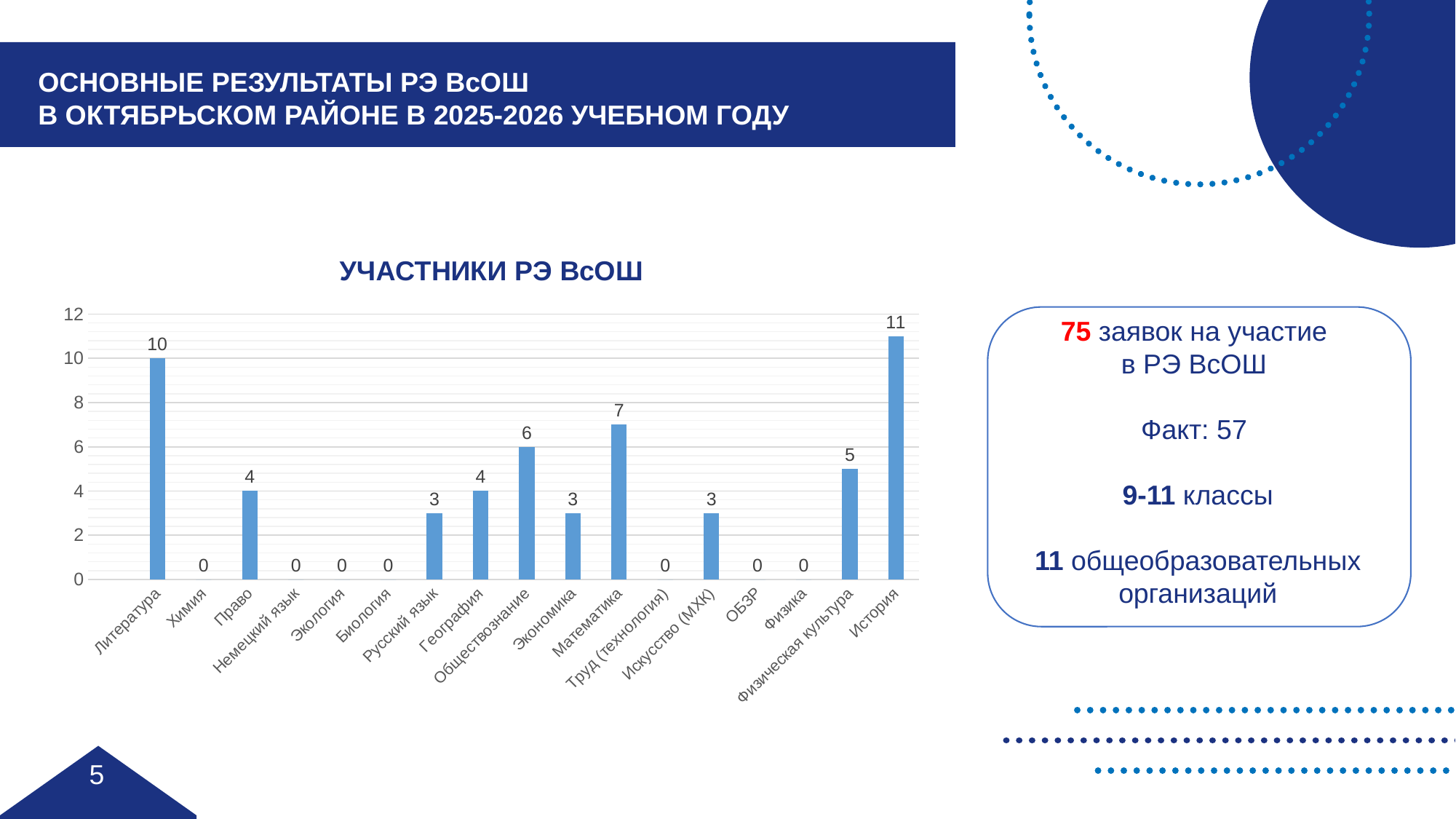
What is the value for Физическая культура in the chart? 5 What is the difference between the values for История and Литература? 1 What is the difference between the values for Математика and Экономика? 4 What is the title of the chart? УЧАСТНИКИ РЭ ВсОШ What kind of chart is shown on the slide? Bar chart Which category has the highest value in the chart? История What is the value for Обществознание in the chart? 6 How many categories are shown on the x axis of the chart? 17 Which is larger, the value for Право or the value for Обществознание? Обществознание What is the value for История in the chart? 11 How many categories in the chart have a value of 0? 7 What is the value for Литература in the chart? 10